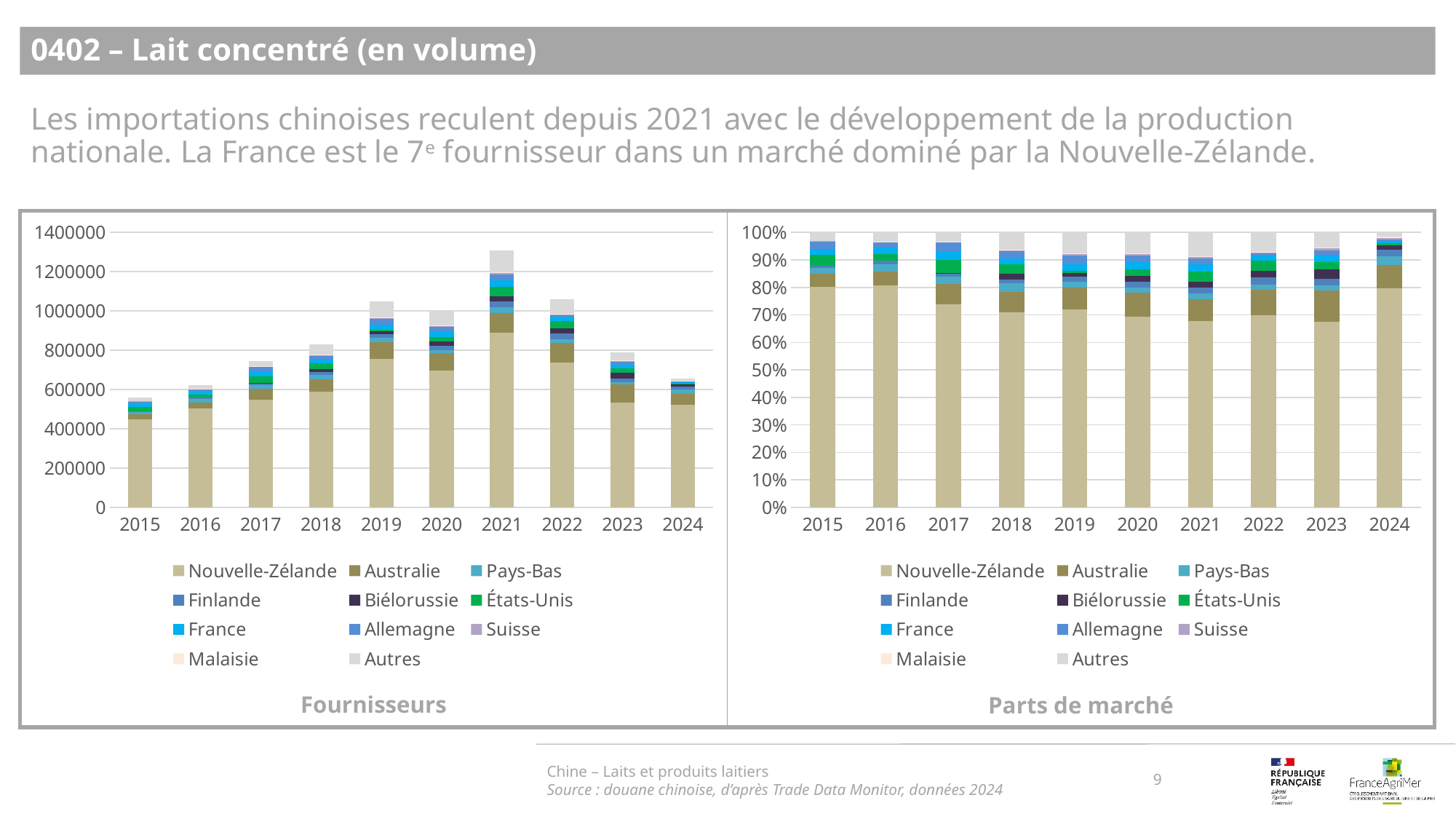
How many series does the legend of the 'Parts de marché' chart list? 11 What kind of chart is the 'Fournisseurs' chart on the left? Stacked bar chart In the 'Parts de marché' chart, which series has the largest share in 2024? Nouvelle-Zélande In the 'Fournisseurs' chart, is the total for 2015 greater or less than 600000? less In the 'Fournisseurs' chart, is the total for 2021 greater or less than 1200000? greater How many years are shown on the x axis of the 'Fournisseurs' chart? 10 In the 'Fournisseurs' chart, which year has the highest total stacked bar? 2021 In the 'Fournisseurs' chart, do the total bars rise or fall from 2021 to 2024? fall In the 'Fournisseurs' chart, do the total bars rise or fall from 2015 to 2021? rise In the 'Fournisseurs' chart, which total is larger, 2022 or 2023? 2022 In the 'Parts de marché' chart, is the share of Nouvelle-Zélande in 2023 greater or less than 70%? less In the 'Fournisseurs' chart, which year has the lowest total stacked bar? 2015